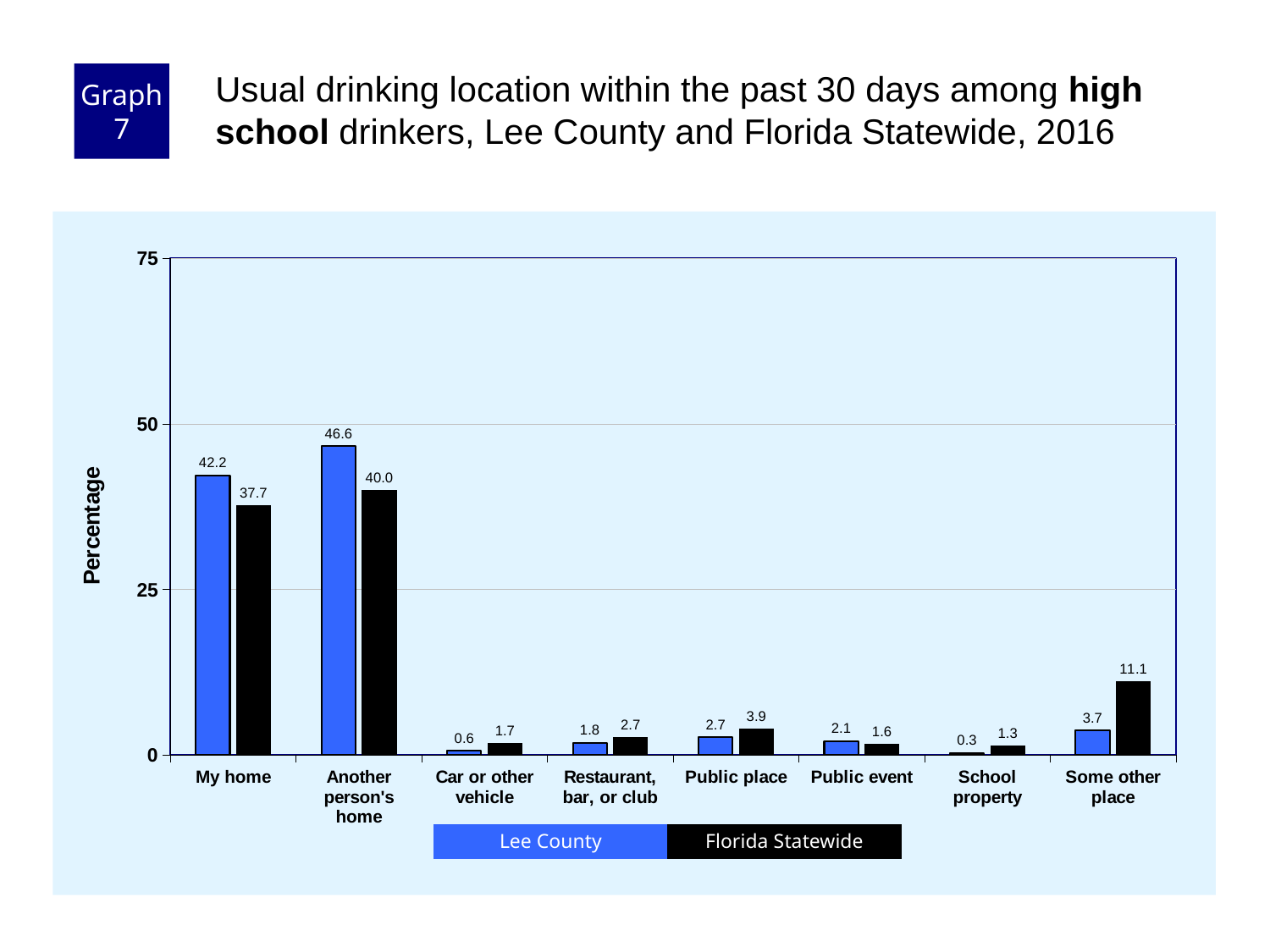
What kind of chart is shown on the slide? Bar chart How many series does the legend list? 2 What is the Lee County value for "Another person's home"? 46.6 What is the difference between the Lee County and Florida Statewide values for "My home"? 4.5 Is the Lee County value for "Another person's home" greater or less than 50? less What is the label of the y axis? Percentage What is the Florida Statewide value for "My home"? 37.7 For "Public place", which is larger: the Lee County value or the Florida Statewide value? Florida Statewide What is the Florida Statewide value for "Some other place"? 11.1 Which category has the highest Lee County value? Another person's home How many categories are shown on the x axis? 8 Which category has the lowest Lee County value? School property